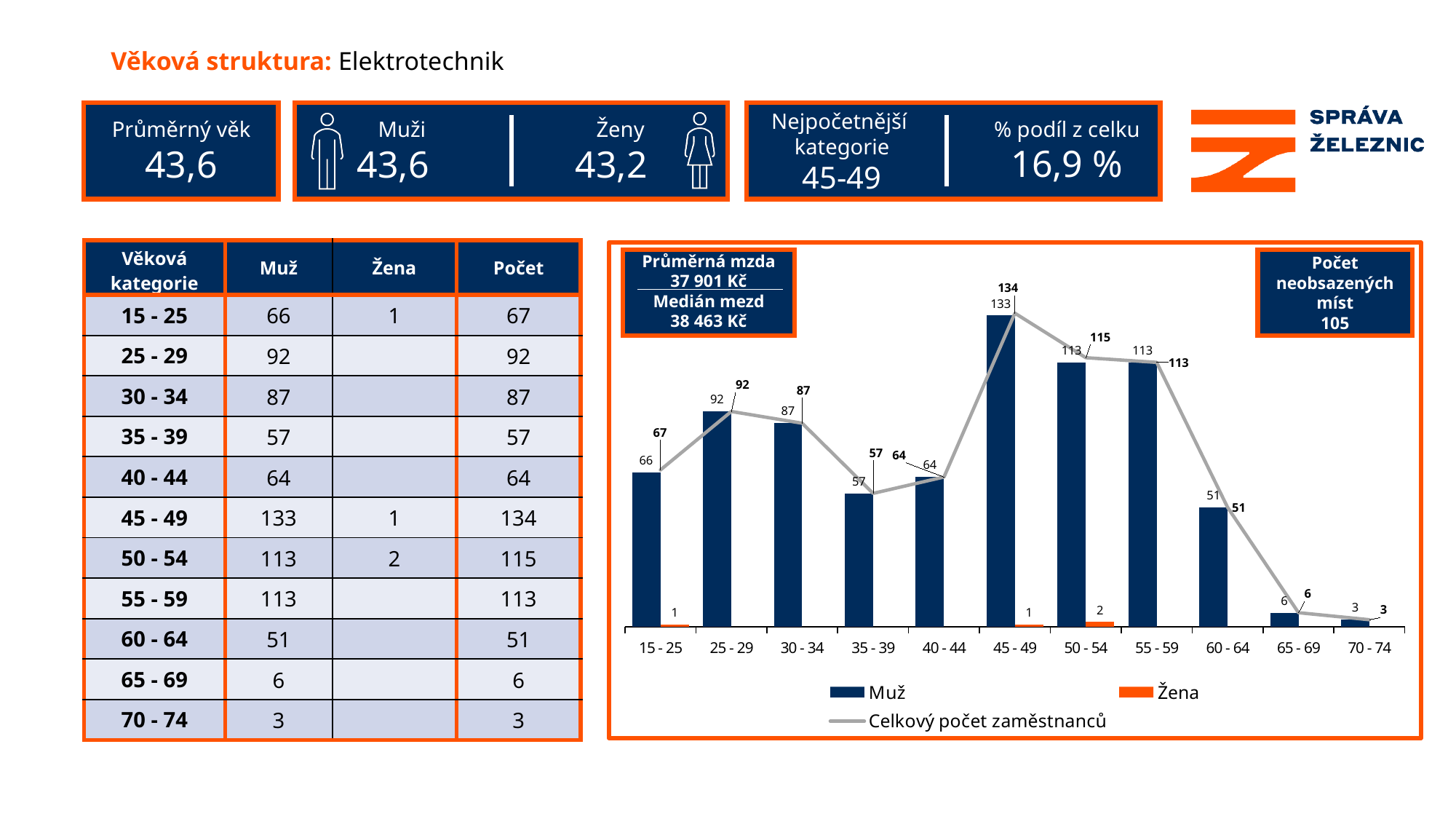
Which age category has the highest value in the Muž series? 45 - 49 What is the value of the Žena series for the 50 - 54 category? 2 What kind of chart is shown on the slide? Bar chart with a line What is the value of the Muž series for the 45 - 49 category? 133 What is the value of the Celkový počet zaměstnanců line for the 50 - 54 category? 115 How many age categories are shown on the x axis of the chart? 11 How many series does the chart legend list? 3 Which category has the larger Muž value, 25 - 29 or 30 - 34? 25 - 29 Which age category has the lowest value in the Muž series? 70 - 74 What is the difference between the Muž values for 45 - 49 and 60 - 64? 82 What colour are the bars for the Žena series? Orange From the 45 - 49 category to the 70 - 74 category, does the Celkový počet zaměstnanců line rise or fall? Fall